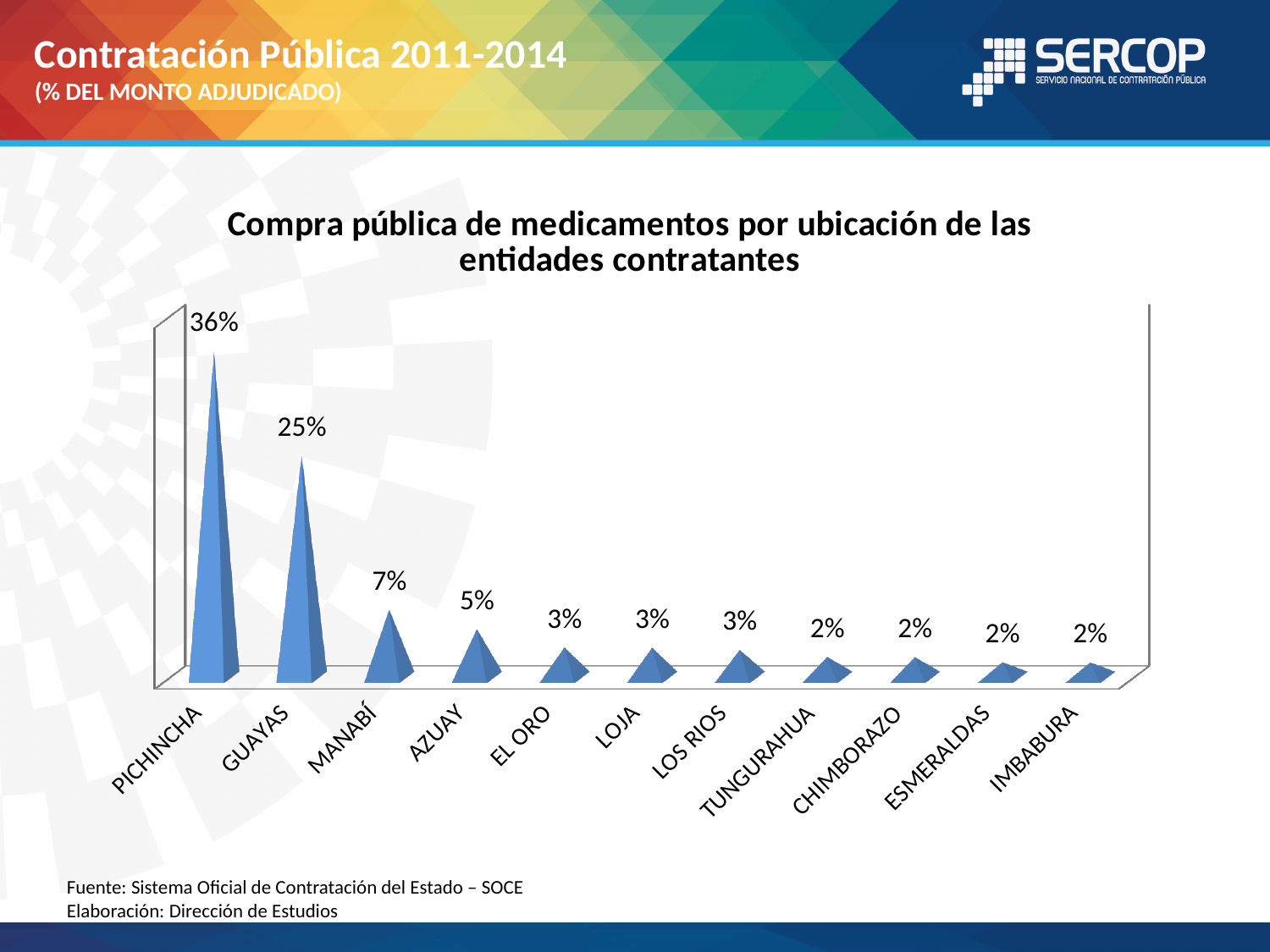
What is the value for LOJA? 3% What is the value for AZUAY? 5% How many categories are shown on the x axis? 11 What is the value for MANABÍ? 7% What is the value for GUAYAS? 25% What is the value for IMBABURA? 2% What is the difference between the values for PICHINCHA and GUAYAS? 11% Do the values rise or fall from left to right along the x axis? fall What is the value for PICHINCHA? 36% Which is larger, the value for MANABÍ or the value for AZUAY? MANABÍ Which category has the highest value? PICHINCHA What is the title of the chart? Compra pública de medicamentos por ubicación de las entidades contratantes